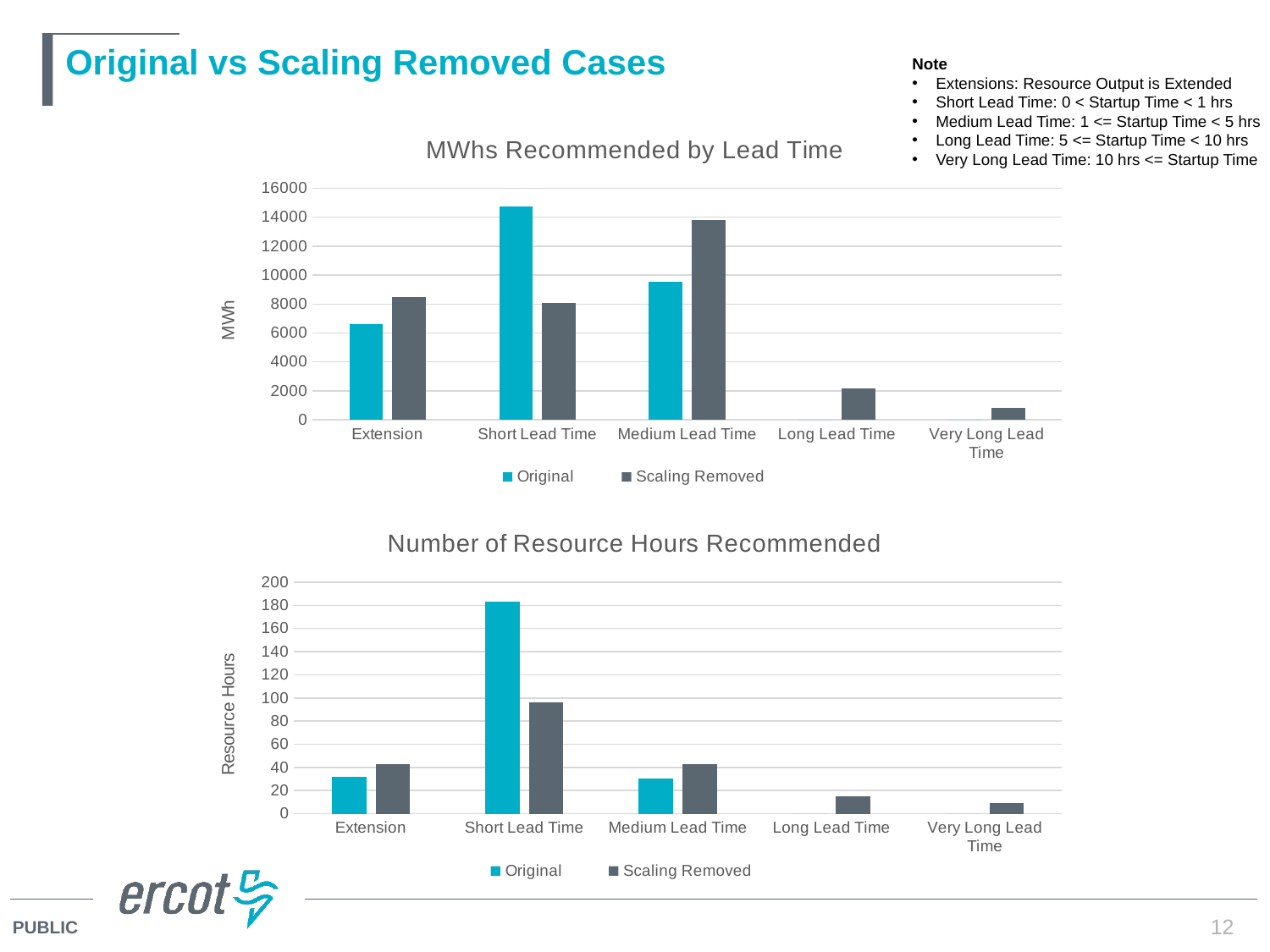
In the 'MWhs Recommended by Lead Time' chart, is the Original value for Short Lead Time greater or less than 14000? greater In the 'Number of Resource Hours Recommended' chart, is the Scaling Removed value for Long Lead Time greater or less than 20? less In the 'Number of Resource Hours Recommended' chart, which category has the highest Scaling Removed value? Short Lead Time In the 'MWhs Recommended by Lead Time' chart, which category has the highest Scaling Removed value? Medium Lead Time In the 'Number of Resource Hours Recommended' chart, for Extension, which series has the larger value: Original or Scaling Removed? Scaling Removed What is the y-axis label of the 'Number of Resource Hours Recommended' chart? Resource Hours In the 'MWhs Recommended by Lead Time' chart, which category has the highest Original value? Short Lead Time In the 'Number of Resource Hours Recommended' chart, is the Original value for Short Lead Time greater or less than 160? greater In the 'MWhs Recommended by Lead Time' chart, for Medium Lead Time, which series has the larger value: Original or Scaling Removed? Scaling Removed How many lead time categories are shown on the x axis of the 'MWhs Recommended by Lead Time' chart? 5 How many series does the legend of the 'MWhs Recommended by Lead Time' chart list? 2 What kind of chart is the 'MWhs Recommended by Lead Time' chart? bar chart